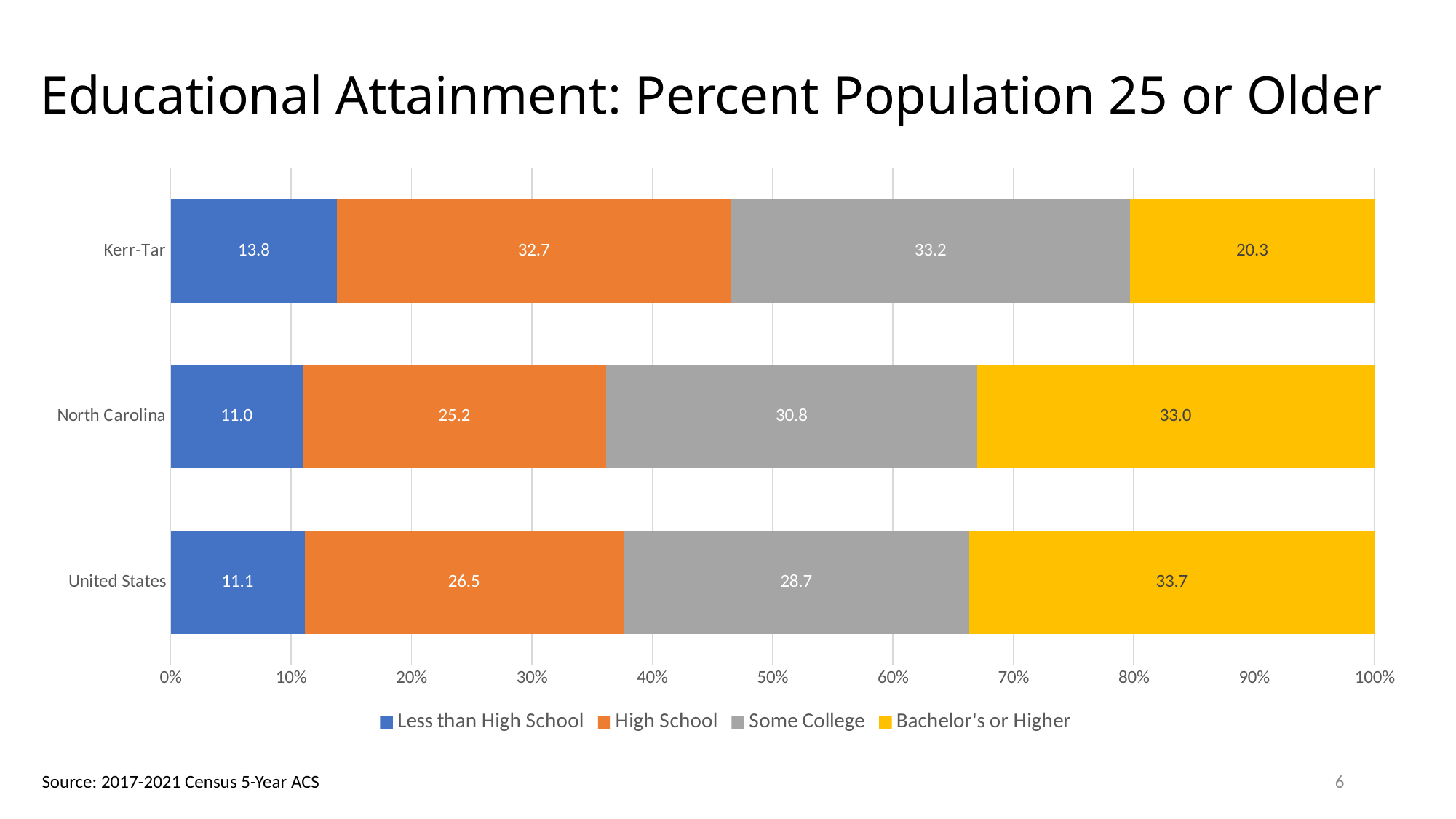
What kind of chart is shown on the slide? Stacked bar chart How many regions are shown on the chart? 3 What is the Bachelor's or Higher value for Kerr-Tar? 20.3 What is the High School value for North Carolina? 25.2 What is the total of the stacked bar for North Carolina? 100.0 What is the Some College value for the United States? 28.7 Which is larger, the High School value for Kerr-Tar or for the United States? Kerr-Tar What is the difference between the Bachelor's or Higher values for the United States and Kerr-Tar? 13.4 What is the title of the chart? Educational Attainment: Percent Population 25 or Older Which region has the highest Less than High School value? Kerr-Tar Which region has the lowest Bachelor's or Higher value? Kerr-Tar How many series does the legend list? 4